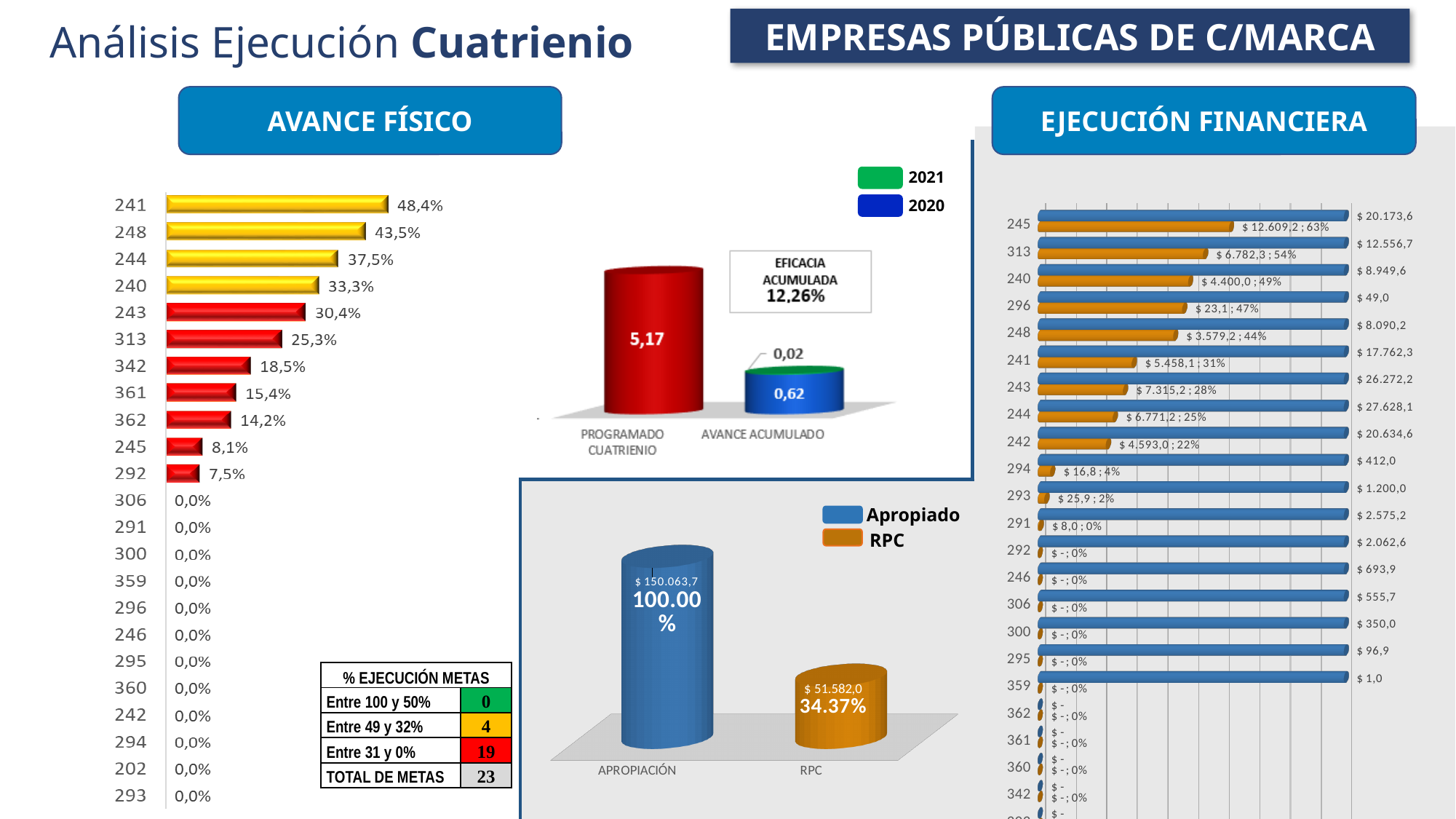
In the AVANCE FÍSICO chart, how many categories are plotted? 23 In the PROGRAMADO CUATRIENIO / AVANCE ACUMULADO chart, how many series does the legend list? 2 What kind of chart is the EJECUCIÓN FINANCIERA chart? Bar chart In the AVANCE FÍSICO chart, what is the difference between the values for 241 and 248? 4,9 percentage points In the AVANCE FÍSICO chart, which category has the highest value? 241 In the EJECUCIÓN FINANCIERA chart, what is the difference between the Apropiado and RPC values for category 245? $ 7.564,4 In the AVANCE FÍSICO chart, which is larger, the value for 243 or the value for 313? 243 In the APROPIACIÓN / RPC chart, what amount is shown for APROPIACIÓN? $ 150.063,7 In the PROGRAMADO CUATRIENIO / AVANCE ACUMULADO chart, what is the value for PROGRAMADO CUATRIENIO? 5,17 In the AVANCE FÍSICO chart, what is the value for category 241? 48,4% In the APROPIACIÓN / RPC chart, what percentage is shown for RPC? 34.37% In the EJECUCIÓN FINANCIERA chart, what is the Apropiado value for category 244? $ 27.628,1